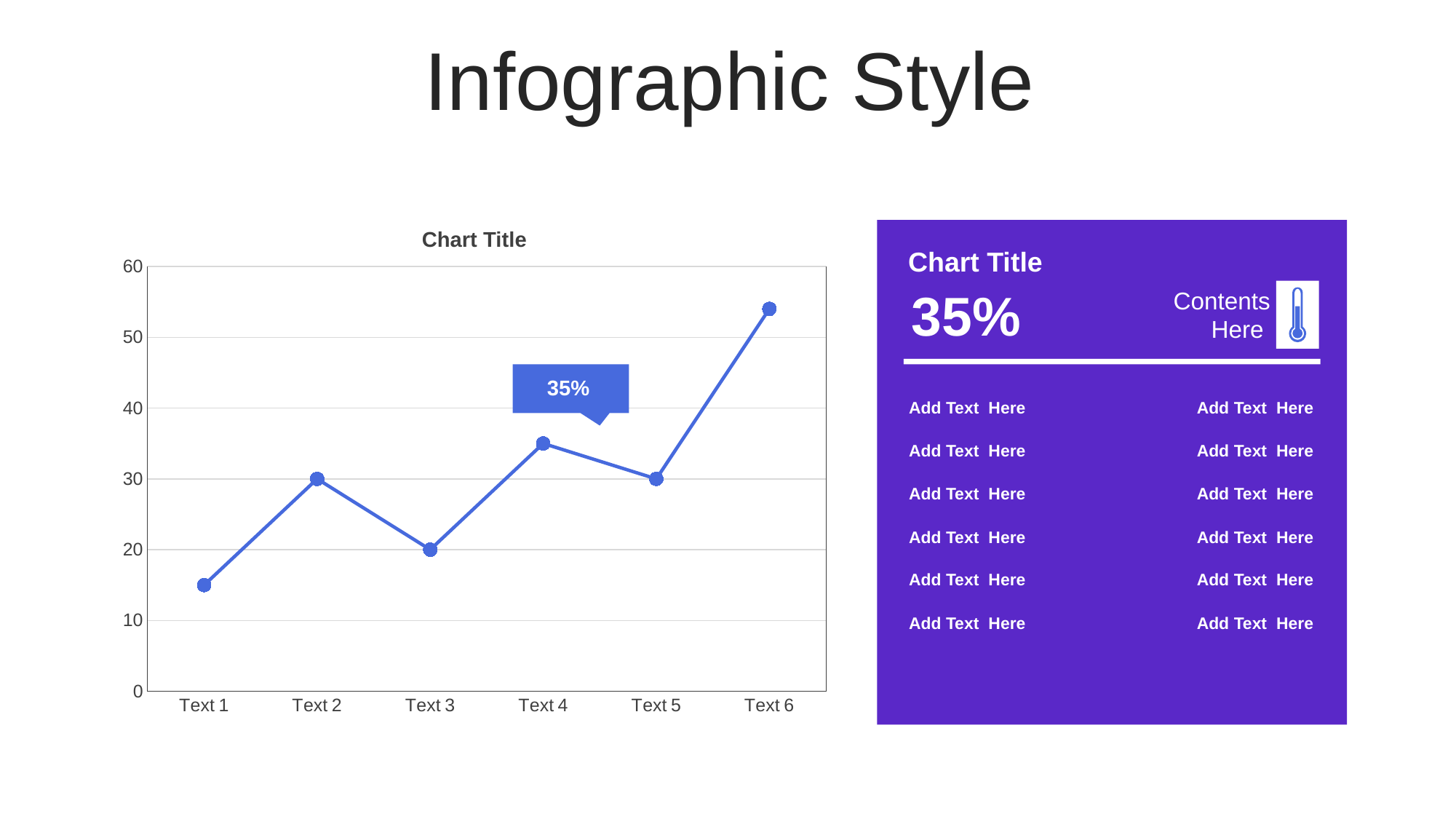
Is the value for Text 6 greater or less than 50? greater What is the value for Text 5? 30 How many categories are plotted along the x axis of the chart? 6 What type of chart is shown on the slide? line chart Is the value for Text 1 greater or less than 20? less What is the title of the chart? Chart Title What is the value for Text 3? 20 Which category has the highest value? Text 6 Which has the larger value, Text 2 or Text 3? Text 2 What is the value for Text 2? 30 Which category has the lowest value? Text 1 What is the difference between the values for Text 2 and Text 3? 10